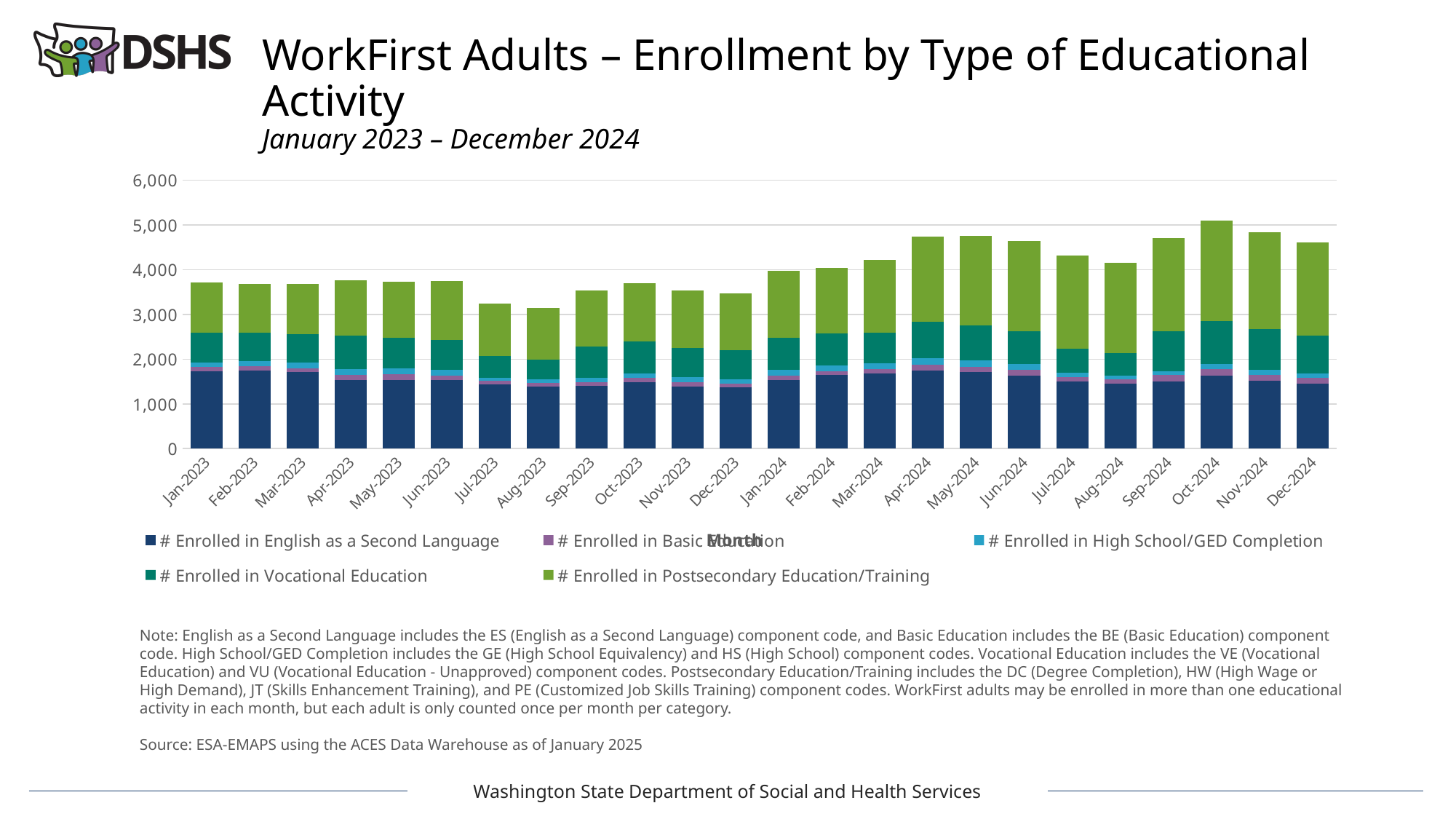
Which series forms the bottom (dark blue) segment of each bar? # Enrolled in English as a Second Language What time period does the chart subtitle cover? January 2023 – December 2024 Is the total enrollment for Apr-2024 greater or less than 4,000? greater Overall, do total enrollments rise or fall from January 2023 to December 2024? rise How many months (bars) are plotted on the chart? 24 Is the total enrollment for Oct-2024 greater or less than 4,000? greater Is the total enrollment for Jan-2023 greater or less than 4,000? less Which month has the larger total enrollment, Dec-2023 or Dec-2024? Dec-2024 What kind of chart is shown on the slide? Stacked bar chart How many series does the legend list? 5 Which month has the highest total enrollment? Oct-2024